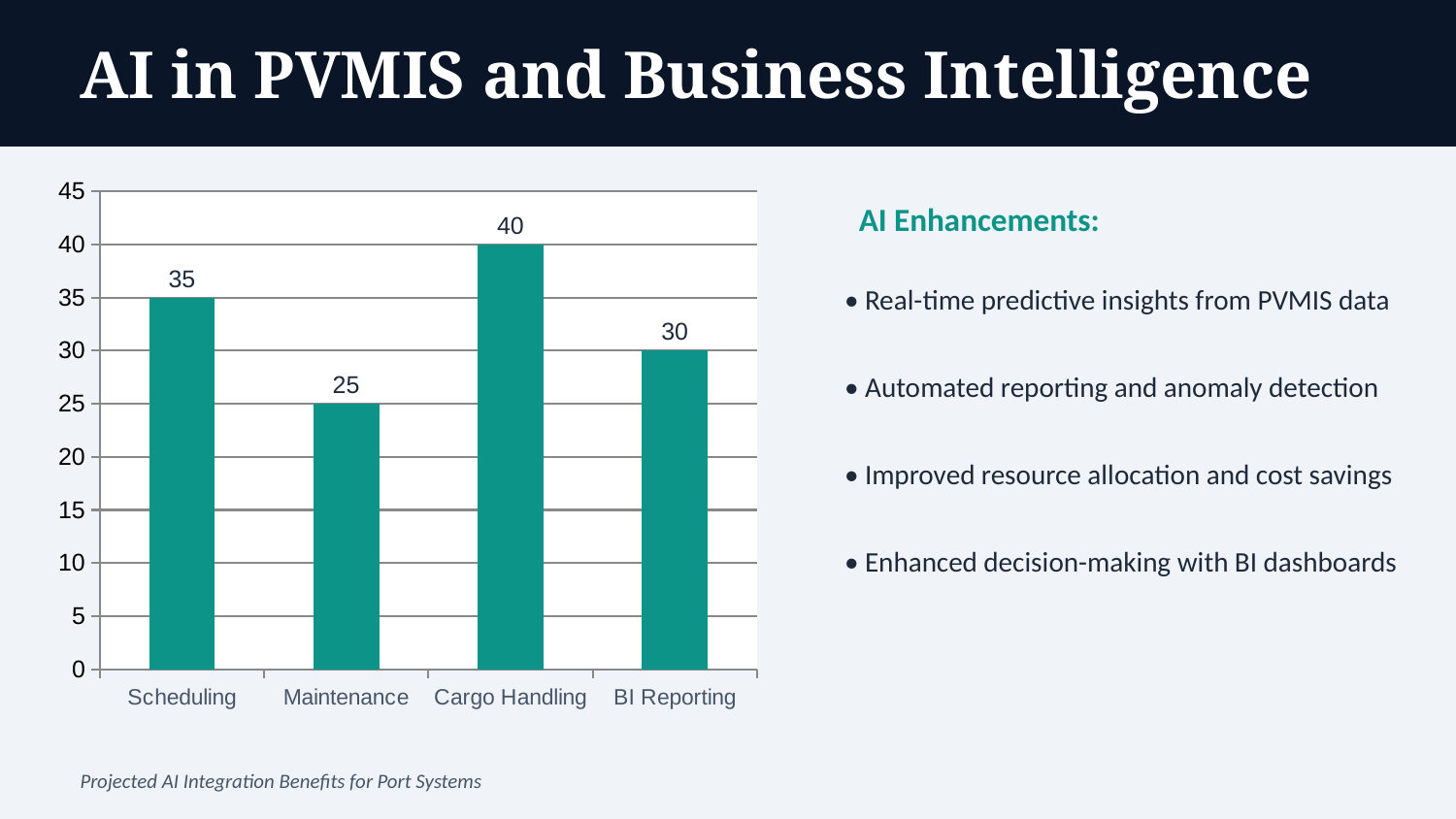
What is the difference between the values for Cargo Handling and Maintenance? 15 What is the value for Maintenance? 25 What is the caption printed below the chart? Projected AI Integration Benefits for Port Systems What is the value for Cargo Handling? 40 What is the difference between the values for Scheduling and BI Reporting? 5 How many categories are shown on the x axis? 4 What is the value for BI Reporting? 30 Which category has the highest value? Cargo Handling What is the value for Scheduling? 35 Which category has the lowest value? Maintenance What kind of chart is shown on the slide? Bar chart Which is larger, the value for Scheduling or the value for BI Reporting? Scheduling